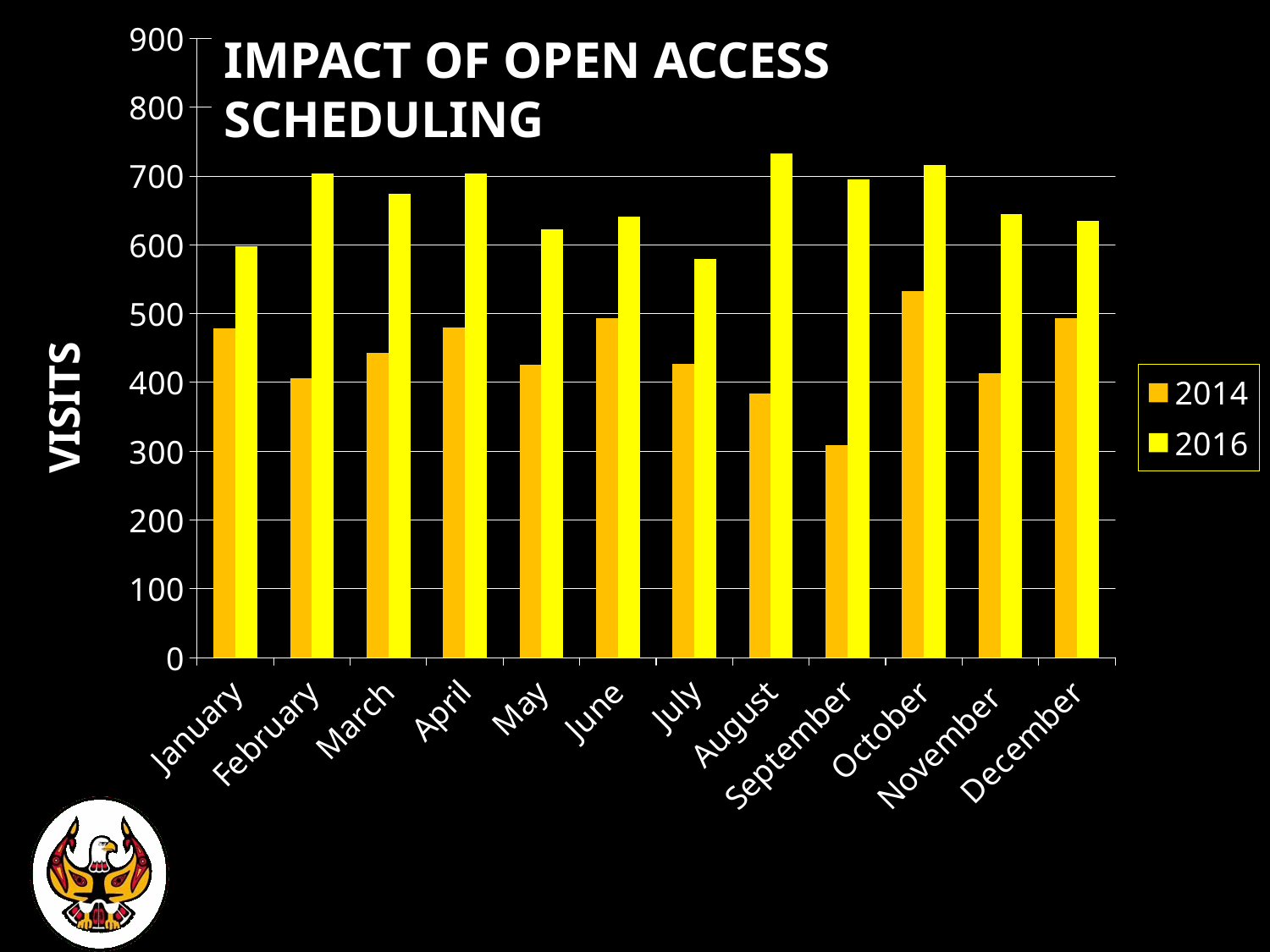
What is the label on the vertical axis? VISITS Which month has the highest value for the 2014 series? October Is the value for August in the 2016 series greater or less than 700? greater Is the value for October in the 2014 series greater or less than 500? greater What is the title of the chart? IMPACT OF OPEN ACCESS SCHEDULING In September, which series has the larger value, 2014 or 2016? 2016 Which month has the lowest value for the 2014 series? September How many months are shown on the x axis? 12 Is the value for July in the 2016 series greater or less than 600? less What kind of chart is shown on the slide? bar chart How many series does the legend list? 2